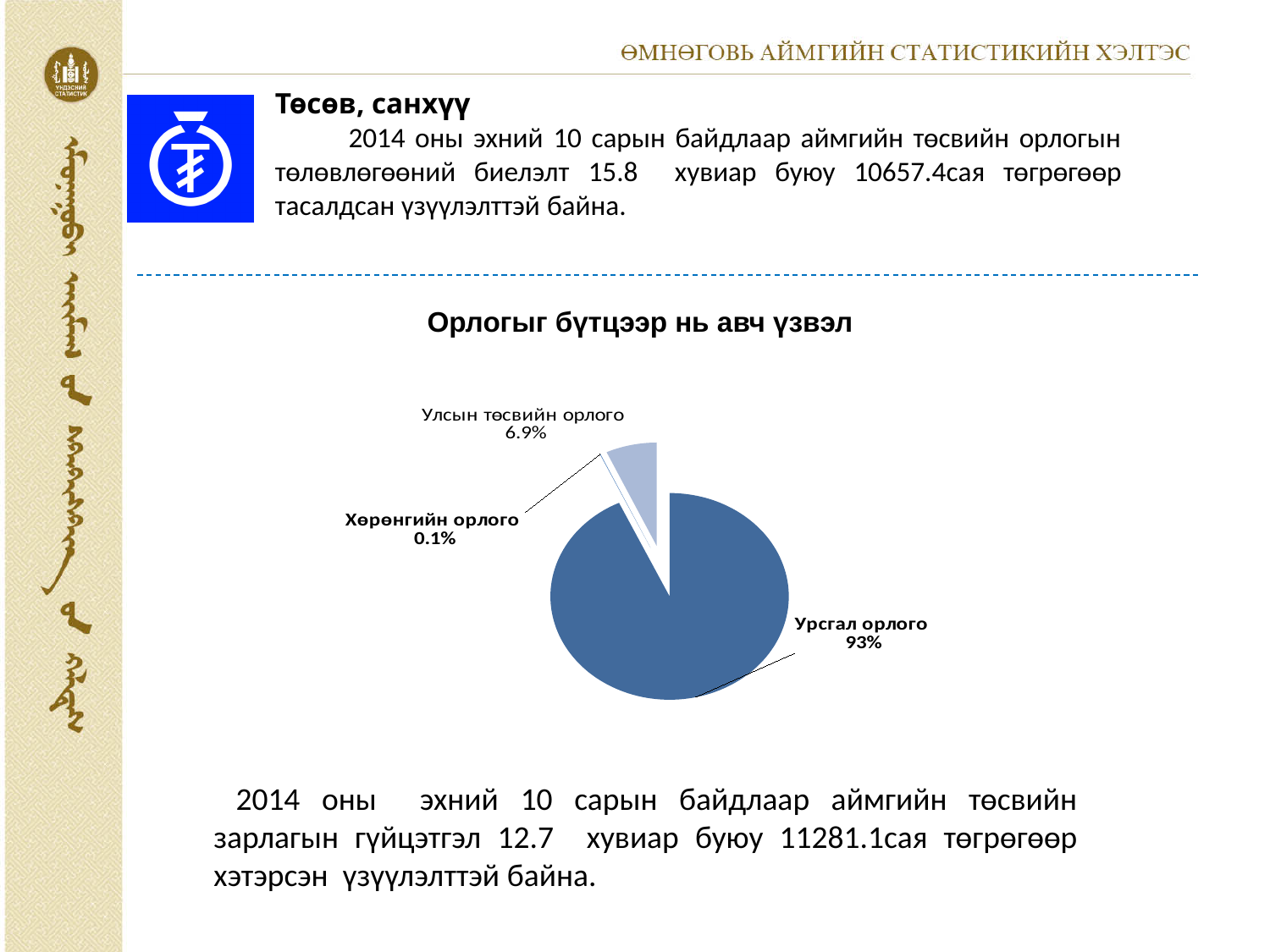
What is the difference between the shares of Урсгал орлого and Улсын төсвийн орлого? 86.1% What colour is the Урсгал орлого slice? dark blue Which category has the largest slice of the pie? Урсгал орлого Which category has the smallest slice of the pie? Хөрөнгийн орлого What share of the pie is Урсгал орлого? 93% What is the difference between the shares of Улсын төсвийн орлого and Хөрөнгийн орлого? 6.8% What share of the pie is Улсын төсвийн орлого? 6.9% What share of the pie is Хөрөнгийн орлого? 0.1% What type of chart is shown on the slide? pie chart What is the title of the chart? Орлогыг бүтцээр нь авч үзвэл How many slices does the pie chart have? 3 Which is larger, Улсын төсвийн орлого or Хөрөнгийн орлого? Улсын төсвийн орлого